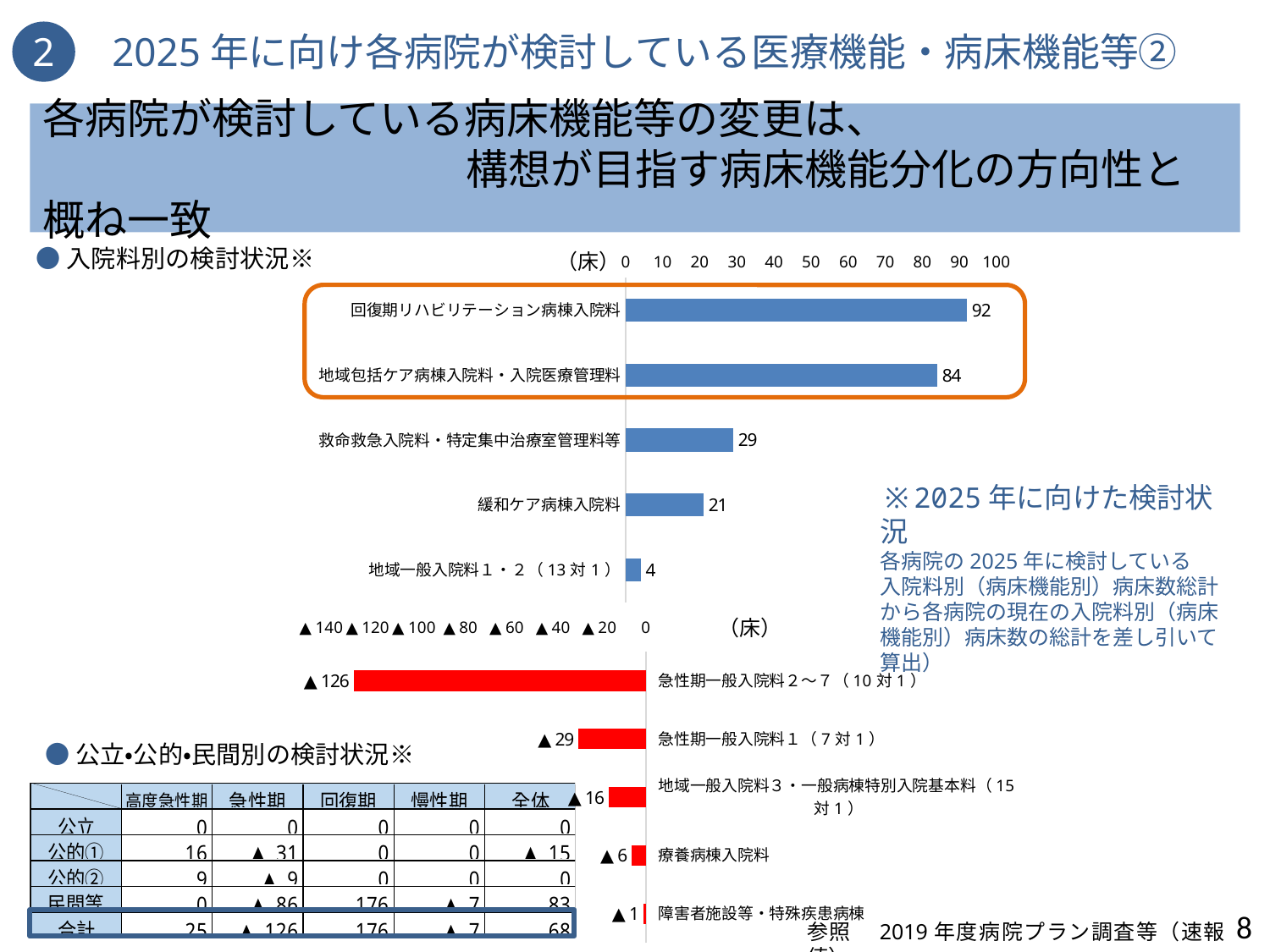
In the upper blue bar chart, what is the value for 回復期リハビリテーション病棟入院料? 92 In the upper blue bar chart, what is the difference between 回復期リハビリテーション病棟入院料 and 地域包括ケア病棟入院料・入院医療管理料? 8 In the lower red bar chart, what is the value for 急性期一般入院料2～7（10対1）? ▲126 In the upper blue bar chart, which category has the highest value? 回復期リハビリテーション病棟入院料 In the lower red bar chart, which category has the largest decrease? 急性期一般入院料2～7（10対1） What type of chart is the upper blue chart? Bar chart In the upper blue bar chart, which category has the lowest value? 地域一般入院料1・2（13対1） In the upper blue bar chart, what is the value for 地域包括ケア病棟入院料・入院医療管理料? 84 In the upper blue bar chart, how many categories are plotted? 5 In the lower red bar chart, how many categories are plotted? 5 In the upper blue bar chart, what is the value for 緩和ケア病棟入院料? 21 In the lower red bar chart, what is the value for 療養病棟入院料? ▲6